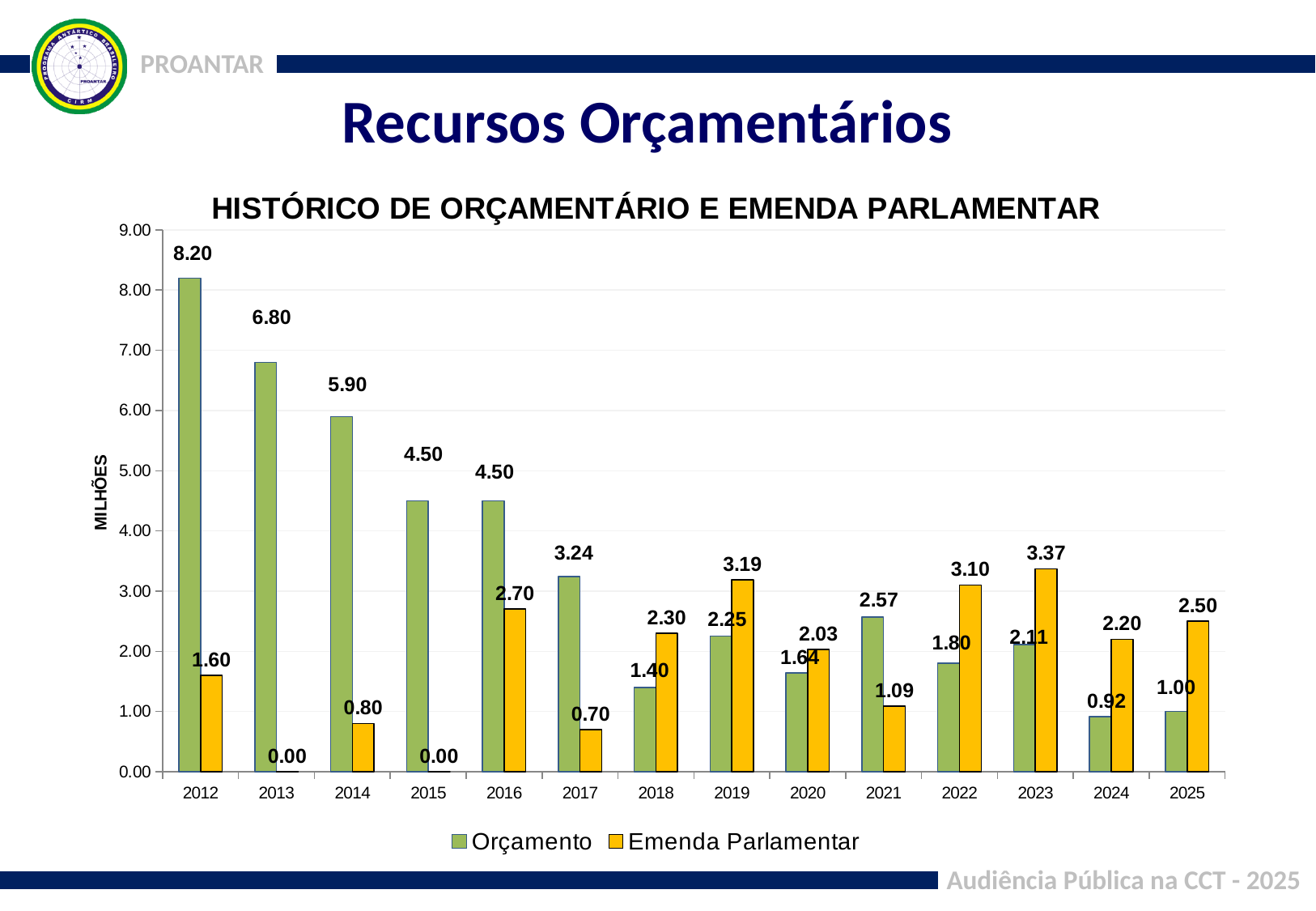
What is the Orçamento value for 2017? 3.24 In 2019, which is larger: Orçamento or Emenda Parlamentar? Emenda Parlamentar Which year has the lowest Orçamento value? 2024 What is the Emenda Parlamentar value for 2023? 3.37 Does the Orçamento series generally rise or fall from 2012 to 2025? Fall What is the Emenda Parlamentar value for 2016? 2.70 How many series does the legend list? 2 Which year has the highest Orçamento value? 2012 What is the Orçamento value for 2012? 8.20 What is the difference between the Orçamento and Emenda Parlamentar values in 2012? 6.60 How many years are shown on the x axis? 14 Which year has the highest Emenda Parlamentar value? 2023